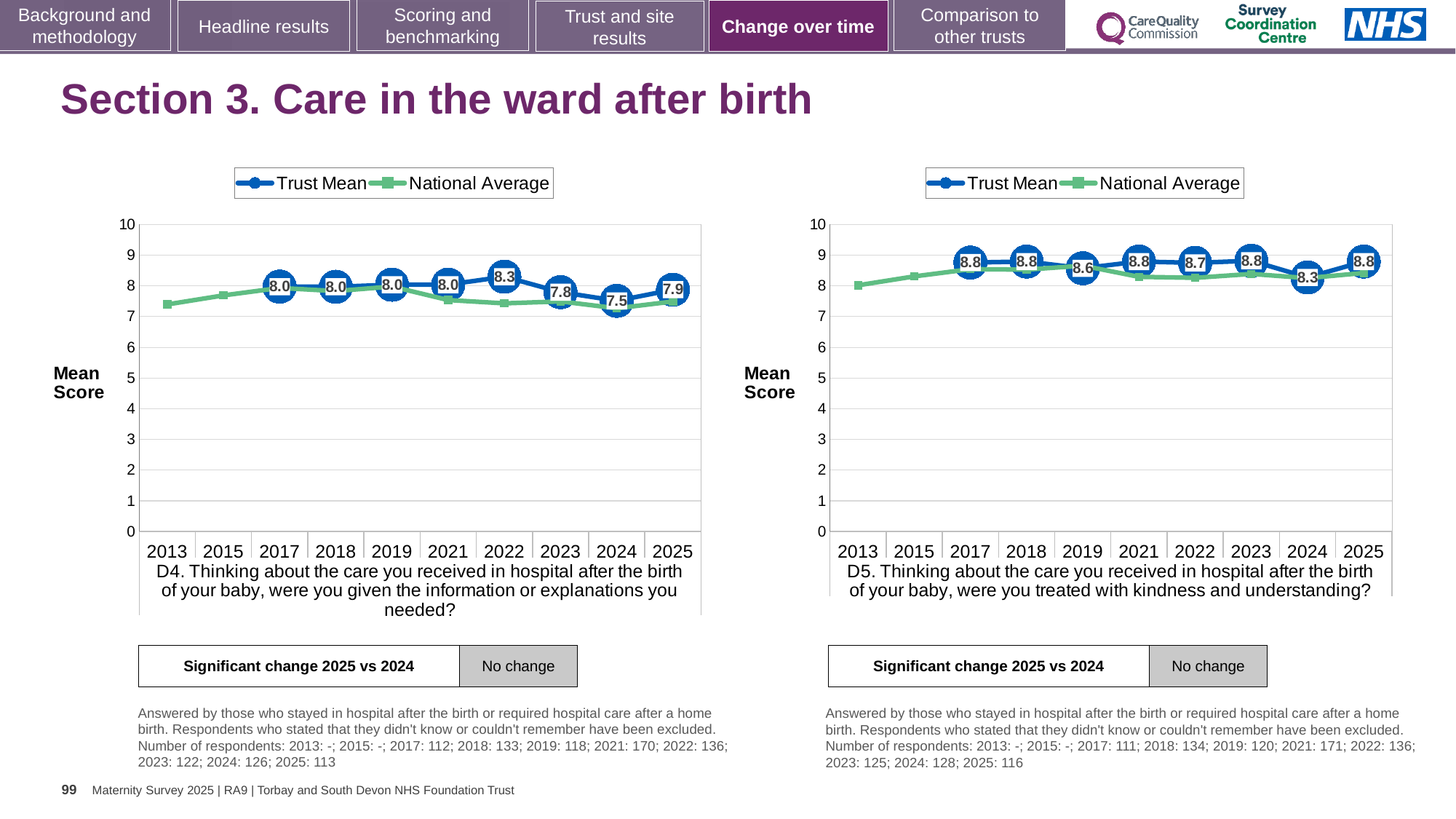
In the right chart (D5), what is the Trust Mean score for 2019? 8.6 In the left chart (D4), what is the Trust Mean score for 2022? 8.3 How many years are shown on the x axis of the left chart (D4)? 10 In the left chart (D4), which year has the highest Trust Mean score? 2022 In the left chart (D4), what is the difference between the Trust Mean scores for 2022 and 2024? 0.8 In the left chart (D4), is the National Average value for 2013 greater or less than 8? less In the left chart (D4), which year has the lowest Trust Mean score? 2024 How many series does the legend of the right chart (D5) list? 2 In the right chart (D5), what is the Trust Mean score for 2024? 8.3 In the left chart (D4), what is the Trust Mean score for 2025? 7.9 In the right chart (D5), is the Trust Mean score for 2025 higher or lower than for 2024? higher In the right chart (D5), which year has the lowest Trust Mean score? 2024